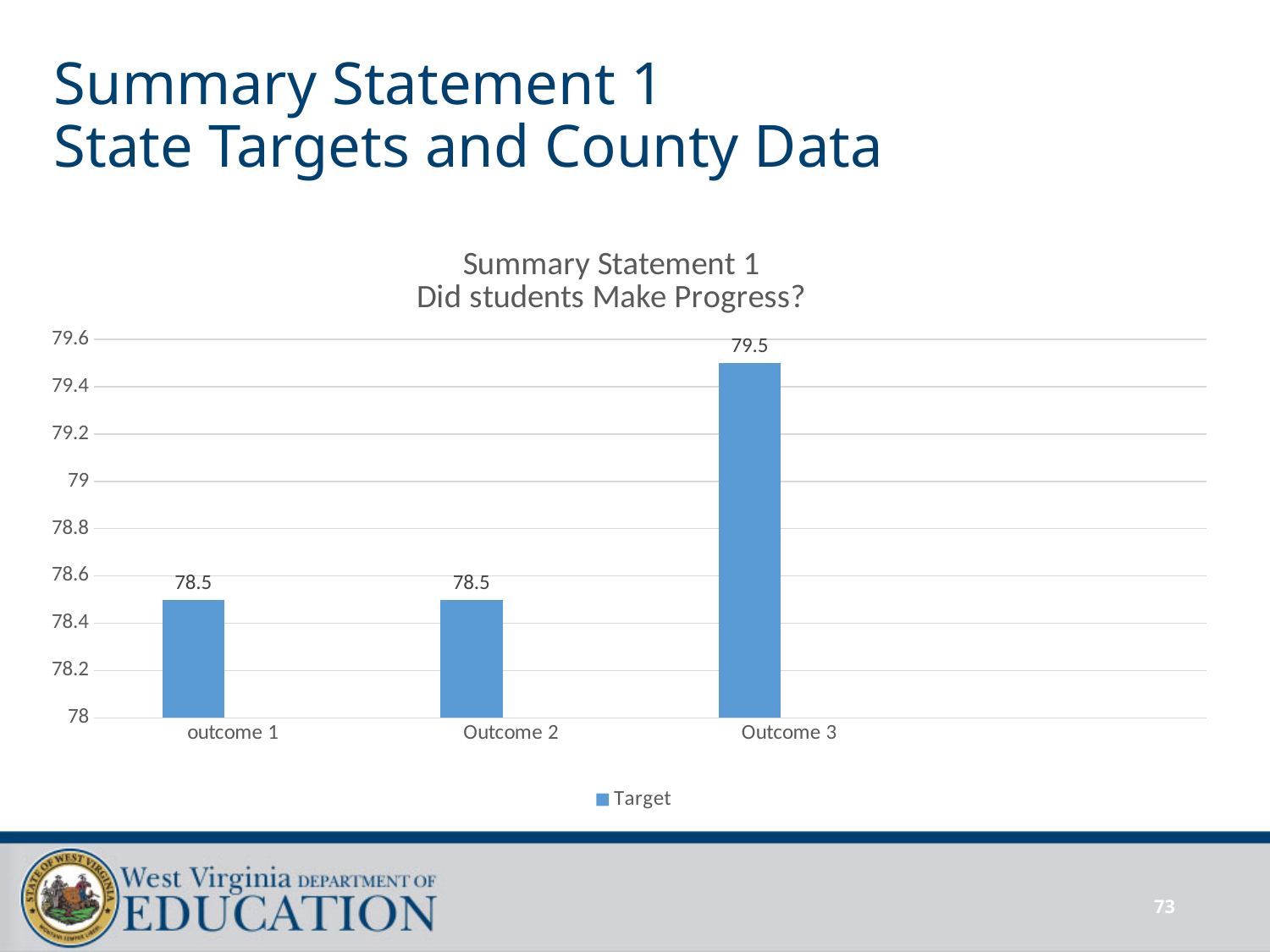
What is the Target value for Outcome 3? 79.5 Which is larger, the Target value for Outcome 3 or for outcome 1? Outcome 3 How many series does the legend list? 1 What is the difference between the Target values for Outcome 3 and Outcome 2? 1 What kind of chart is shown on the slide? Bar chart What is the Target value for outcome 1? 78.5 Is the Target value for outcome 1 greater or less than 79? less Which outcome has the highest Target value? Outcome 3 What is the Target value for Outcome 2? 78.5 Is the Target value for Outcome 3 greater or less than 79? greater How many outcomes are shown on the chart? 3 What is the name of the series shown in the legend? Target